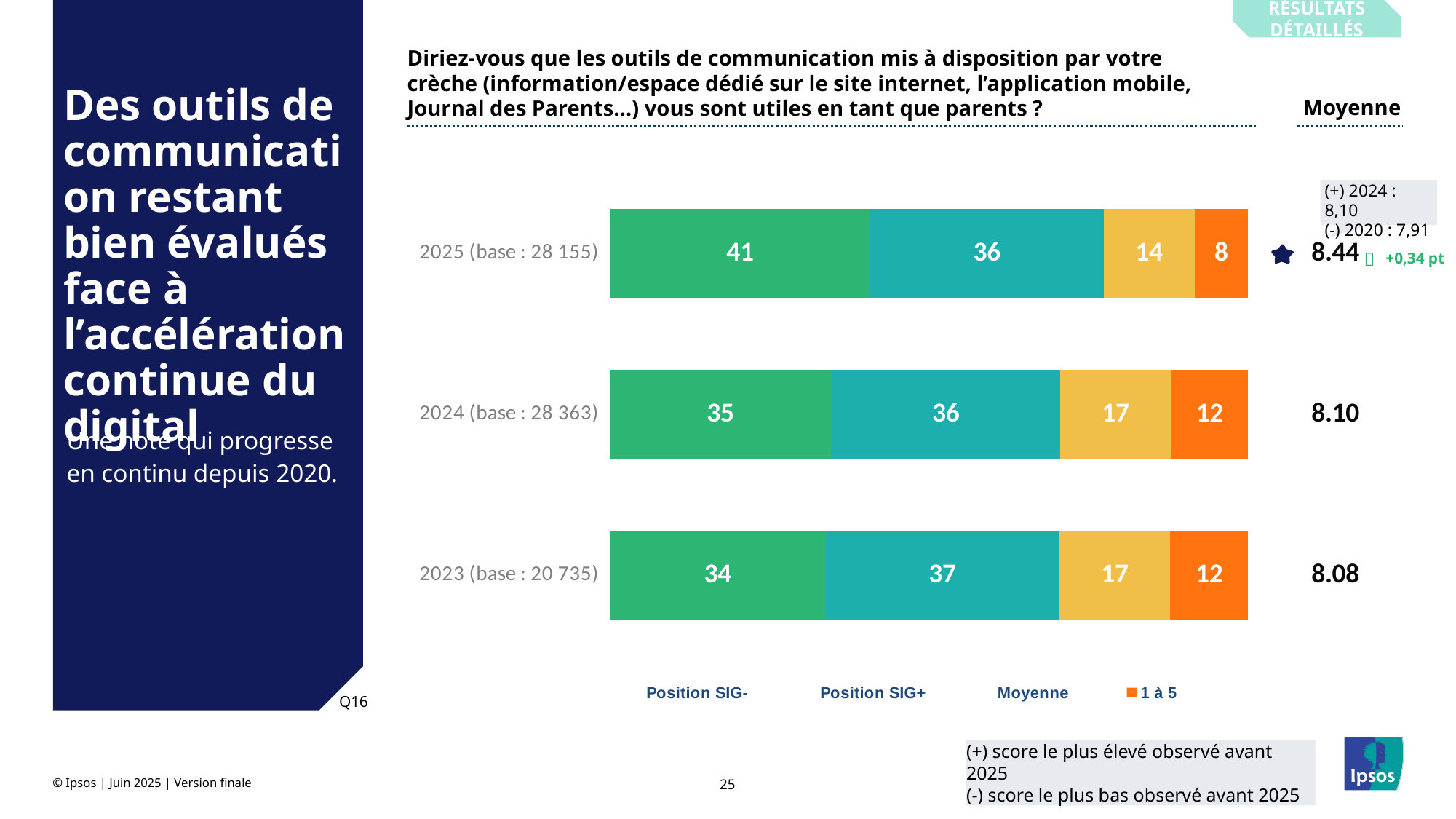
Which year has the smallest orange "1 à 5" segment? 2025 (base : 28 155) How many bars (years) are shown in the chart? 3 Which year has the largest green segment? 2025 (base : 28 155) What is the total of the stacked bar for 2024 (base : 28 363)? 100 What is the difference between the green segment values for 2025 and 2024? 6 How many entries does the legend list? 4 What kind of chart is shown on the slide? Stacked bar chart Which is larger: the teal segment for 2023 or the teal segment for 2024? 2023 What is the Moyenne shown for 2025? 8.44 What is the value of the green segment for 2025 (base : 28 155)? 41 What is the value of the orange "1 à 5" segment for 2024 (base : 28 363)? 12 Does the green segment value rise or fall from 2023 to 2025? Rise